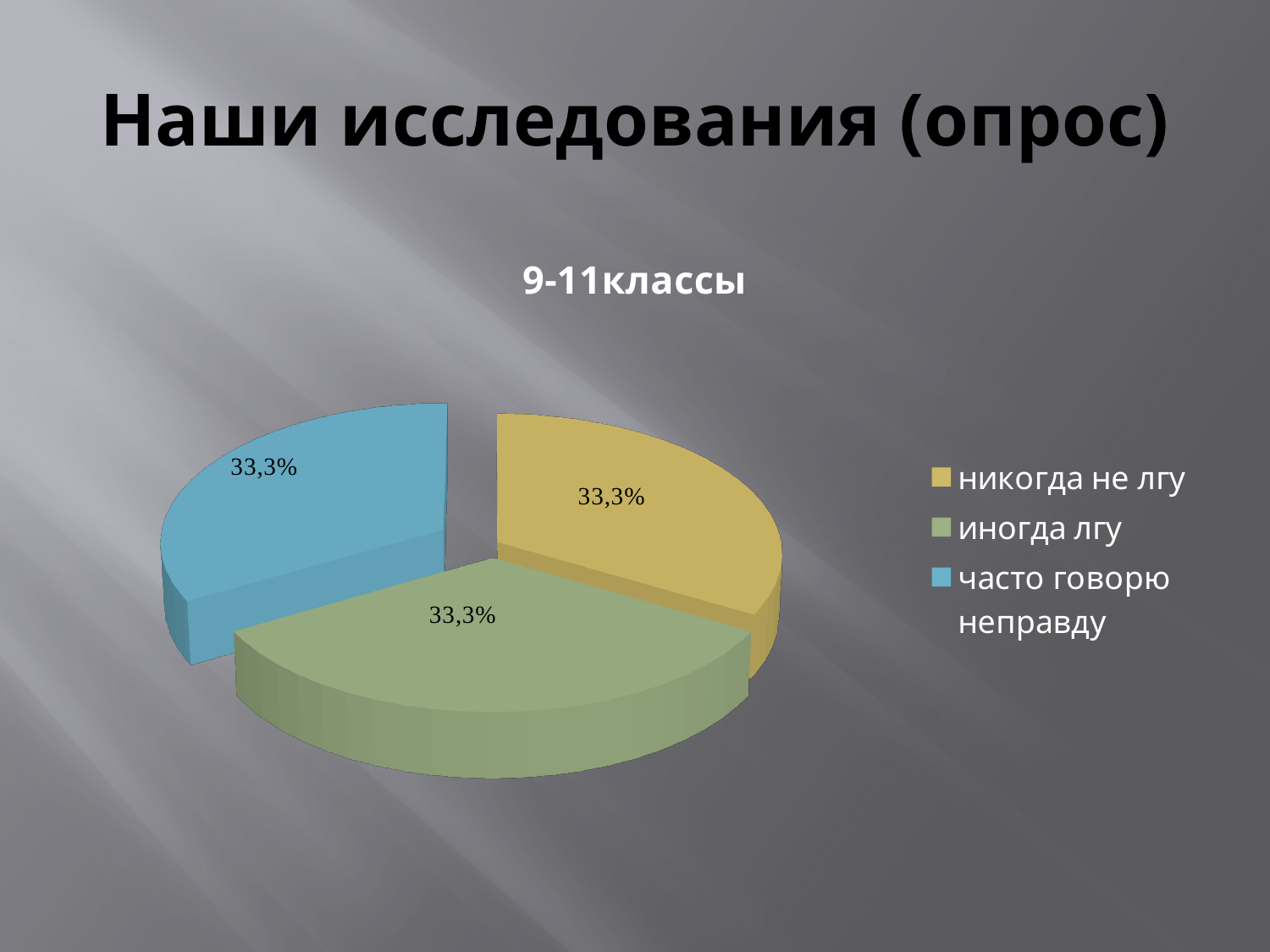
How many slices does the pie chart have? 3 Which legend entry is shown in blue? часто говорю неправду What is the chart title shown above the pie chart? 9-11классы What percentage is shown for the slice "никогда не лгу"? 33,3% What percentage is shown for the slice "иногда лгу"? 33,3% What is the difference between the values for "никогда не лгу" and "иногда лгу"? 0% What share of the pie does the "иногда лгу" slice represent? 33,3% What kind of chart is shown on the slide? pie chart What percentage is shown for the slice "часто говорю неправду"? 33,3% How many entries does the legend list? 3